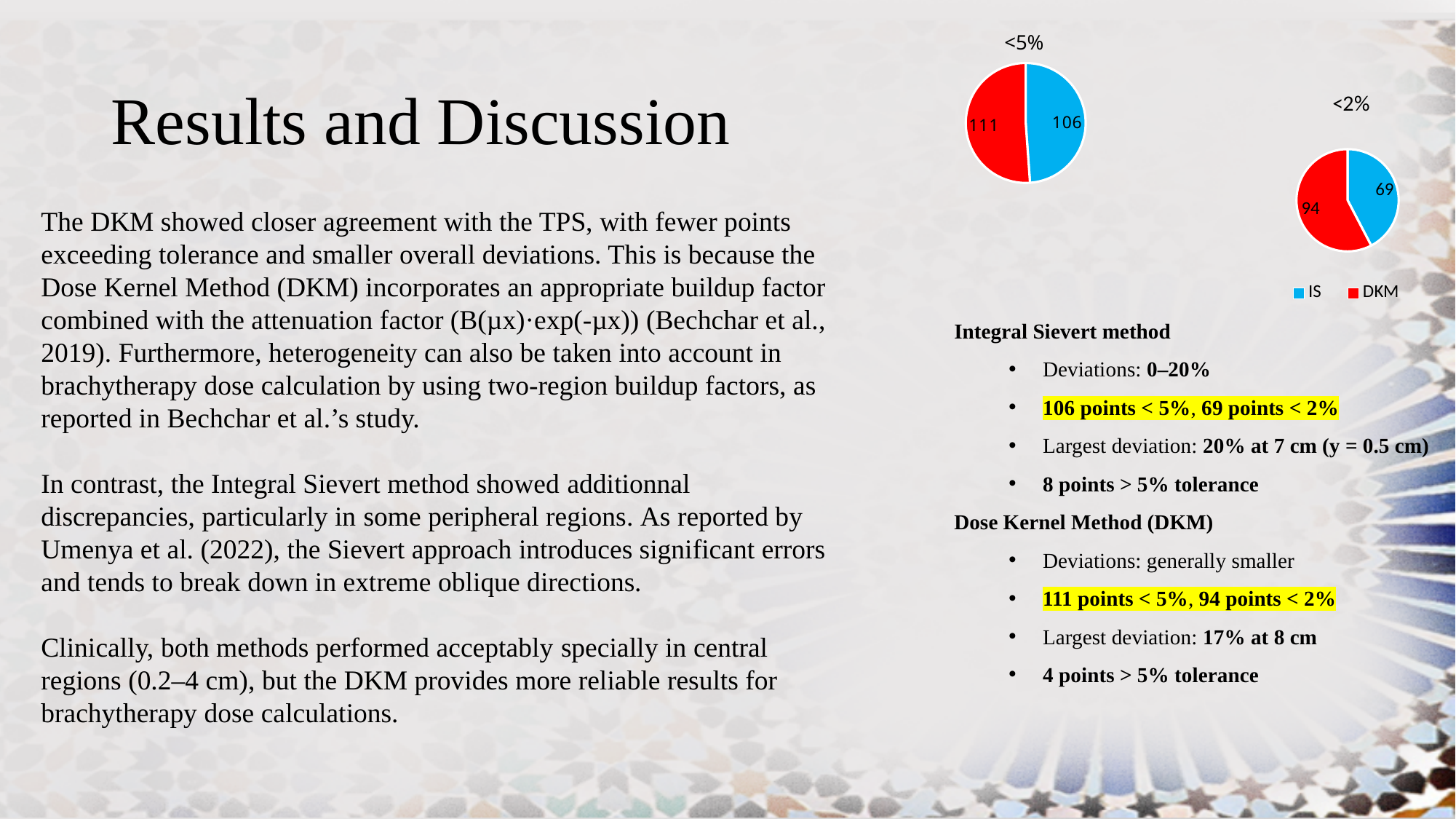
In the "<2%" pie chart, is the value for DKM larger or smaller than the value for IS? larger In the "<2%" pie chart, which method has the smaller slice? IS In the "<5%" pie chart, what is the value for IS? 106 In the "<5%" pie chart, what is the value for DKM? 111 In the "<2%" pie chart, what is the value for DKM? 94 In the "<2%" pie chart, what is the value for IS? 69 In the pie charts, which colour represents DKM? red In the "<2%" pie chart, which method has the larger slice? DKM How many series does the legend list for the pie charts? 2 What type of chart is used for the "<5%" and "<2%" charts? pie chart In the "<2%" pie chart, what is the difference between the DKM and IS values? 25 In the "<5%" pie chart, what is the difference between the DKM and IS values? 5